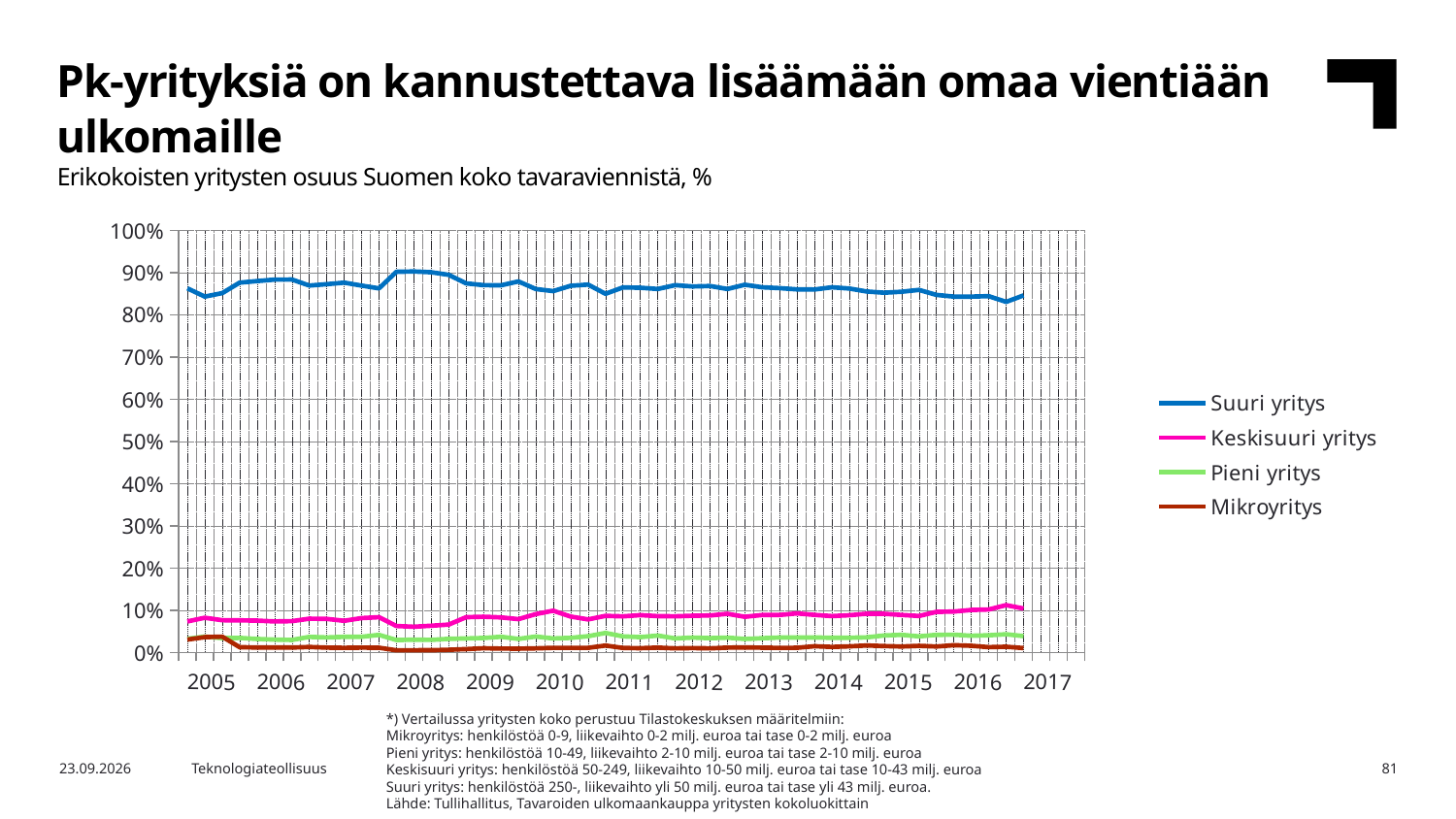
Which series has the larger values, Keskisuuri yritys or Pieni yritys? Keskisuuri yritys How many series does the legend list? 4 Is the value for Suuri yritys in 2005 greater or less than 80%? greater Is the value for Keskisuuri yritys in 2016 greater or less than 20%? less Which series has the highest values throughout the chart? Suuri yritys Which series has the lowest values throughout the chart? Mikroyritys Is the value for Pieni yritys in 2013 greater or less than 10%? less What is the subtitle describing the chart's content? Erikokoisten yritysten osuus Suomen koko tavaraviennistä, % How many years are labelled on the x axis? 13 What kind of chart is shown on the slide? Line chart What colour is the line for Suuri yritys? Blue